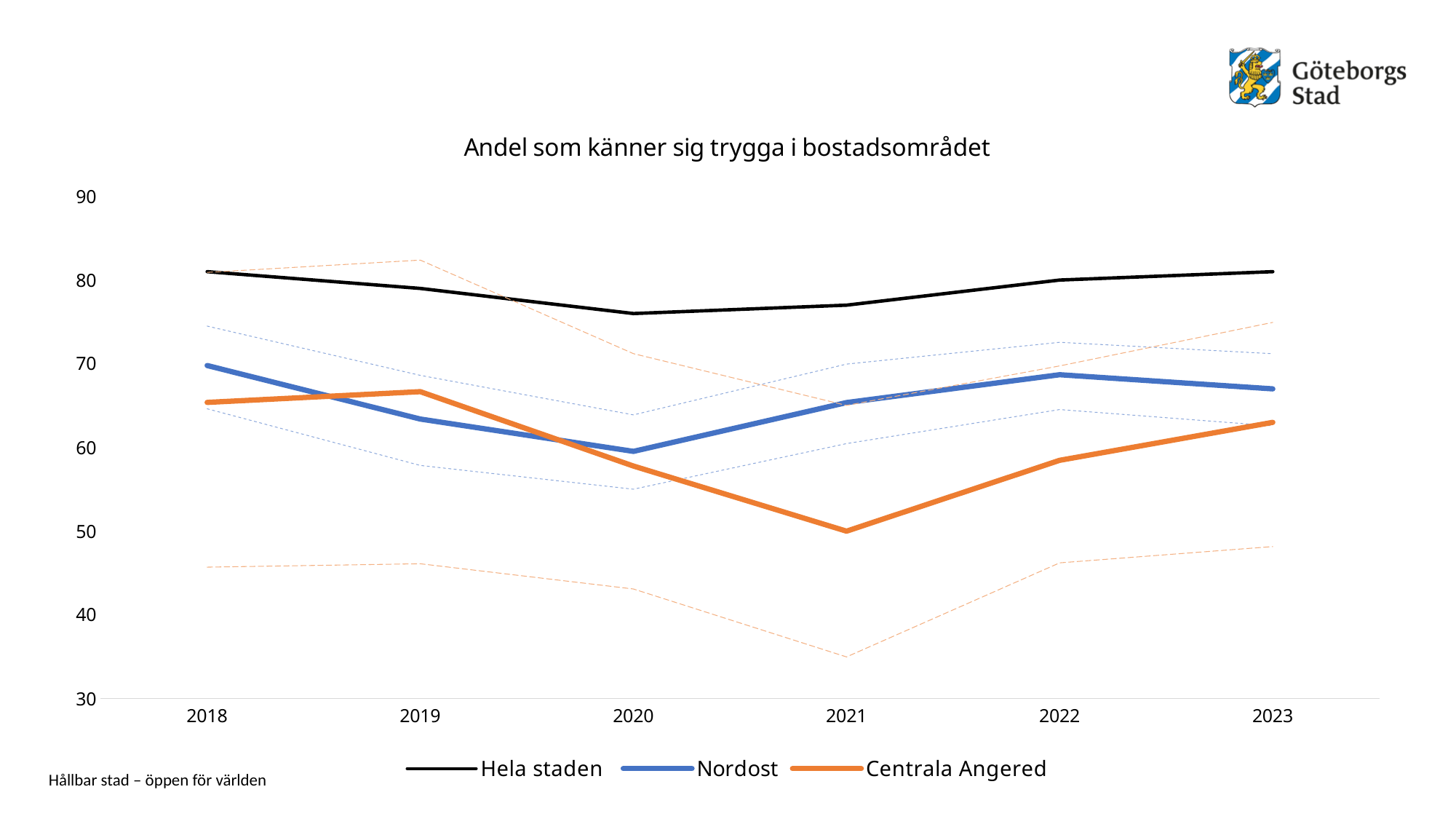
What is the title of the chart? Andel som känner sig trygga i bostadsområdet Does the value for Centrala Angered rise or fall from 2021 to 2023? rise Is the value for Hela staden in 2020 greater or less than 80? less Which series is drawn in orange? Centrala Angered How many series does the legend list? 3 Is the value for Centrala Angered in 2021 greater or less than 60? less What kind of chart is shown on the slide? line chart In which year is the value for Nordost lowest? 2020 Is the value for Nordost in 2018 greater or less than 60? greater In 2021, which is larger: the value for Nordost or the value for Centrala Angered? Nordost How many years are shown on the x axis? 6 In which year is the value for Centrala Angered lowest? 2021